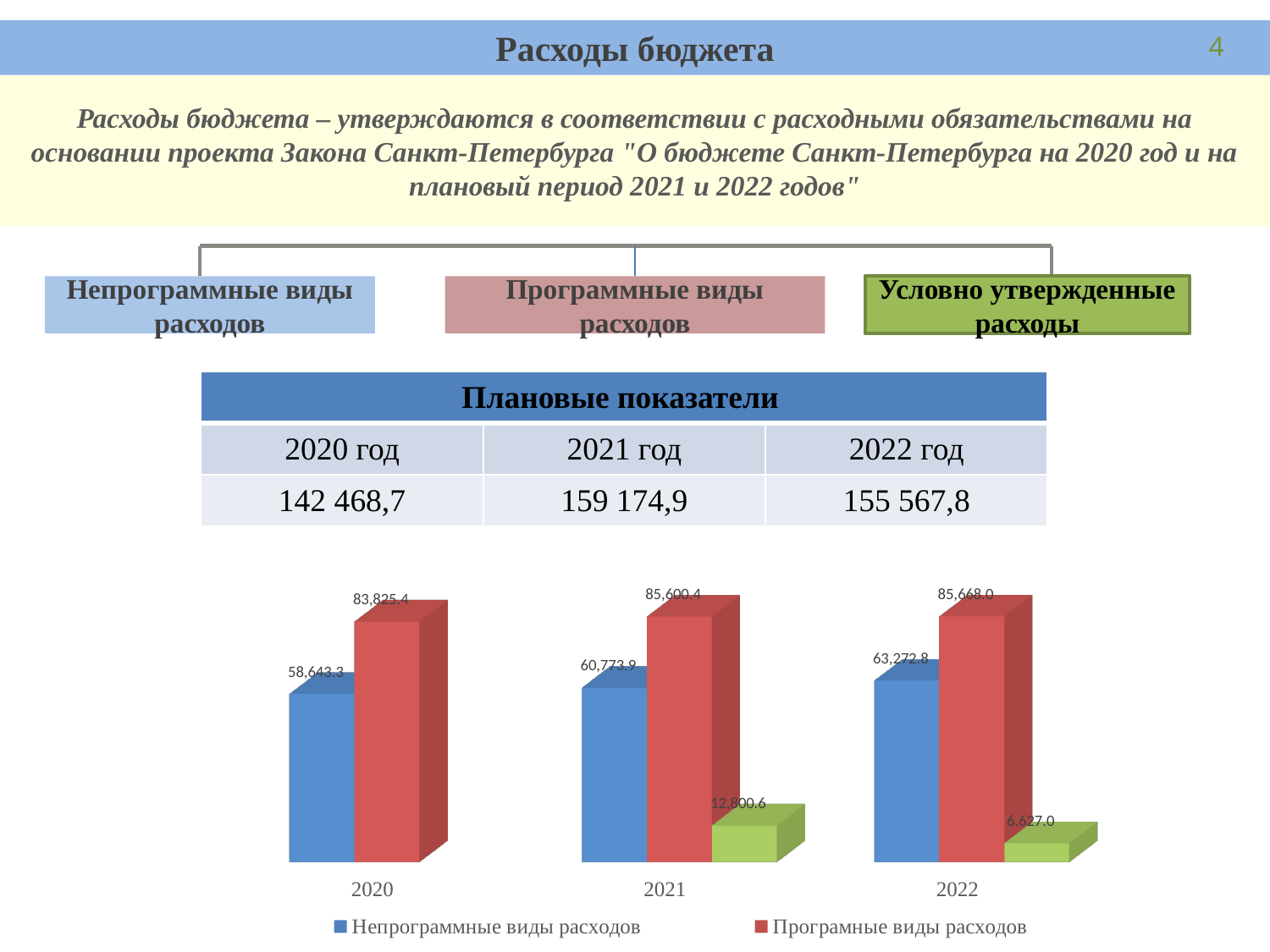
What is the value of the green bar for 2022? 6,627.0 In which year is Непрограммные виды расходов lowest? 2020 What is the difference between the green bar values for 2021 and 2022? 6,173.6 In which year is Непрограммные виды расходов highest? 2022 What is the value of Програмные виды расходов for 2022? 85,668.0 Does Непрограммные виды расходов rise or fall from 2020 to 2022? rise How many years are shown on the x axis of the chart? 3 What is the value of Програмные виды расходов for 2021? 85,600.4 How many series does the chart legend list? 2 Which is larger in 2021: Непрограммные виды расходов or Програмные виды расходов? Програмные виды расходов What is the difference between Програмные виды расходов and Непрограммные виды расходов in 2020? 25,182.1 What is the value of Непрограммные виды расходов for 2020? 58,643.3